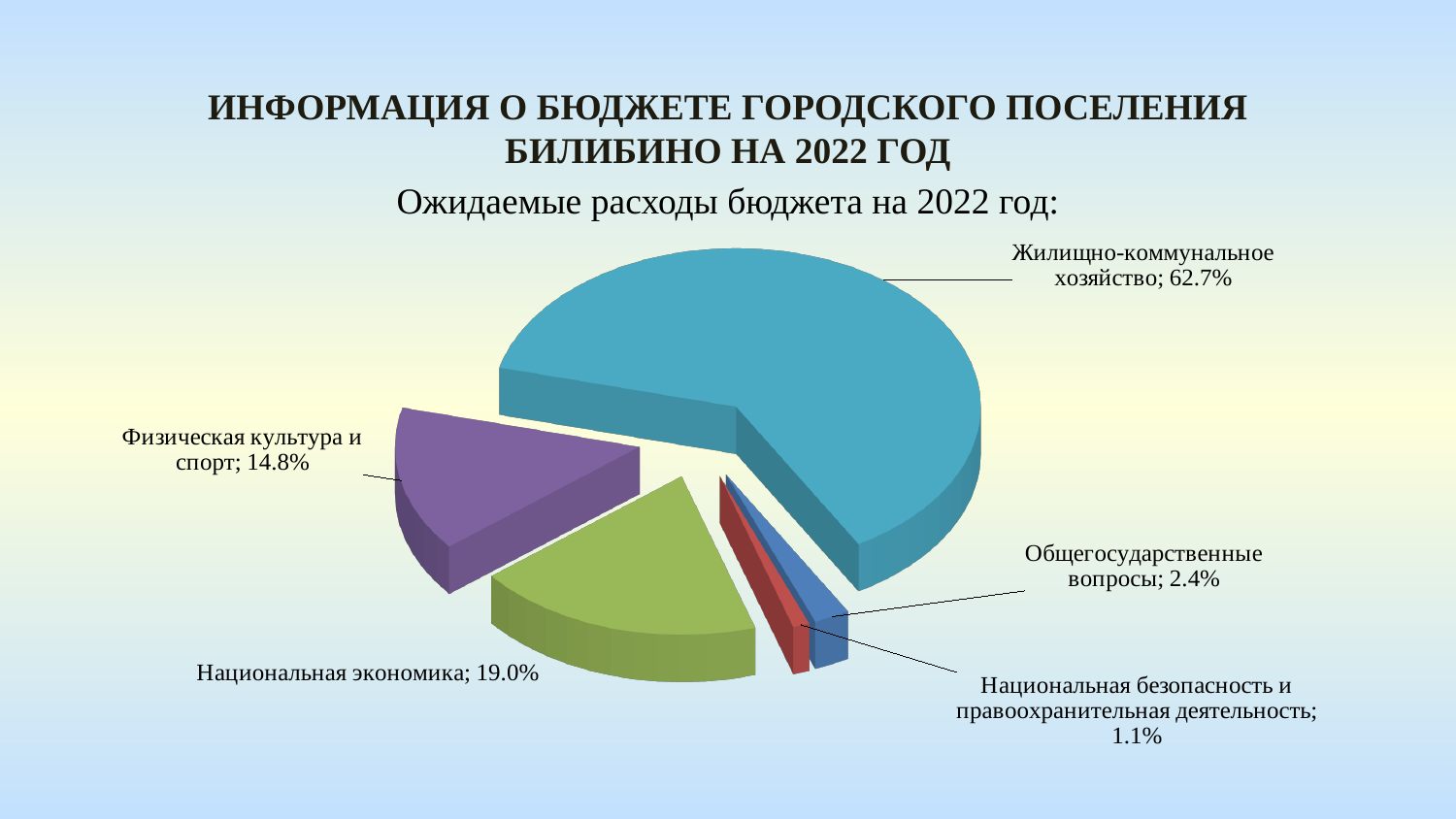
What kind of chart is shown on the slide? Pie chart Which is larger: the share for Общегосударственные вопросы or for Национальная безопасность и правоохранительная деятельность? Общегосударственные вопросы Which category has the largest share of the pie? Жилищно-коммунальное хозяйство What share of the pie does Жилищно-коммунальное хозяйство have? 62.7% What is the value for Общегосударственные вопросы? 2.4% What is the value shown for Национальная экономика? 19.0% What share is shown for Национальная безопасность и правоохранительная деятельность? 1.1% How many categories are shown in the pie chart? 5 What is the difference between the shares of Национальная экономика and Физическая культура и спорт? 4.2% What percentage is shown for Физическая культура и спорт? 14.8% Which category has the smallest share of the pie? Национальная безопасность и правоохранительная деятельность What colour is the slice for Национальная экономика? Green